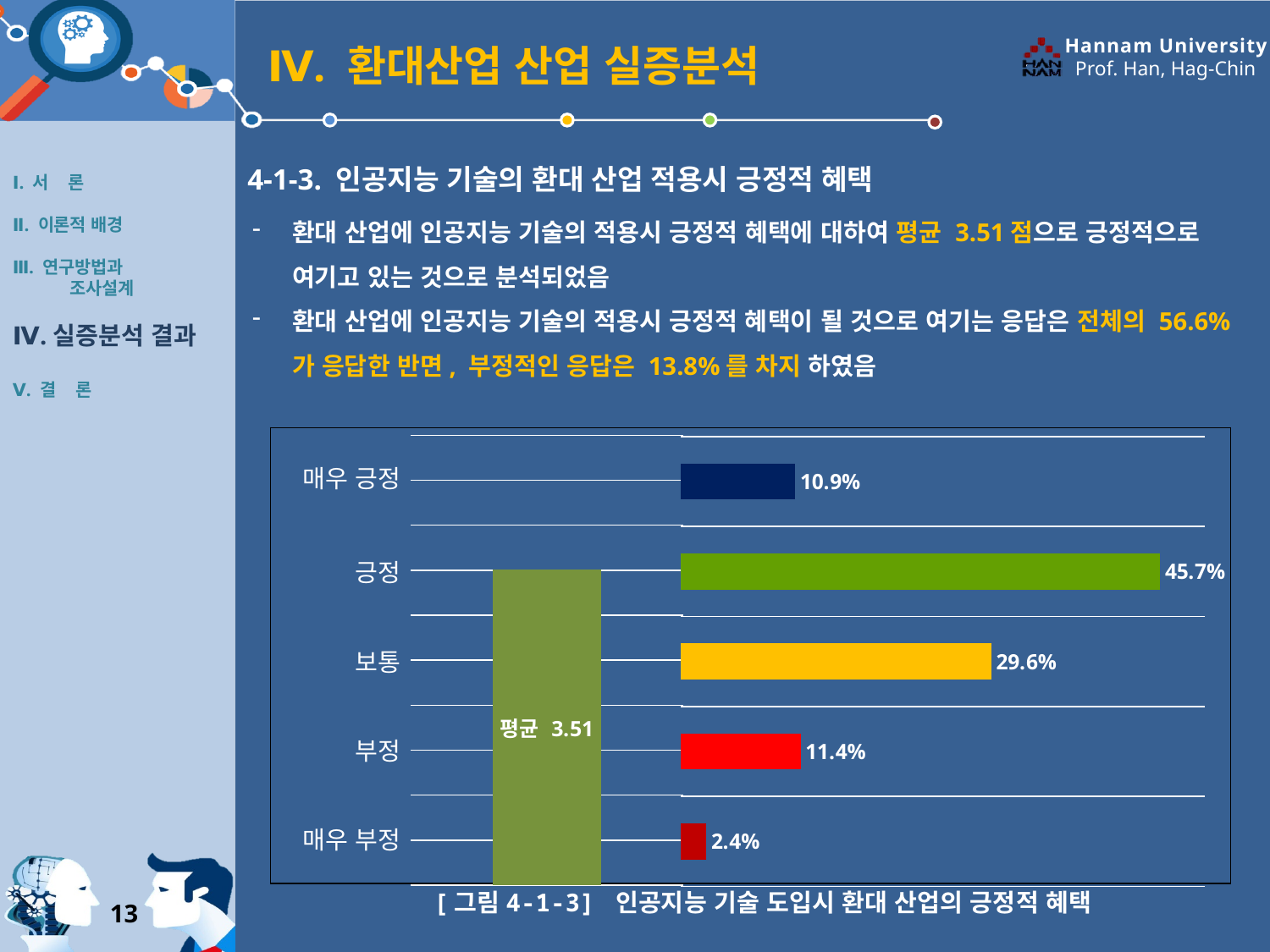
What is the value for 보통 in the chart? 29.6% What is the combined value of 매우 긍정 and 긍정 in the chart? 56.6% Which category has the lowest value in the chart? 매우 부정 What kind of chart is shown on the slide? Bar chart Which category has the highest value in the chart? 긍정 What is the value for 매우 긍정 in the chart? 10.9% What is the value for 긍정 in the chart? 45.7% What is the difference between the values for 긍정 and 보통? 16.1% How many categories are shown in the chart? 5 What is the value for 매우 부정 in the chart? 2.4% What average value (평균) is printed inside the chart? 3.51 Which is larger, the value for 부정 or the value for 매우 긍정? 부정